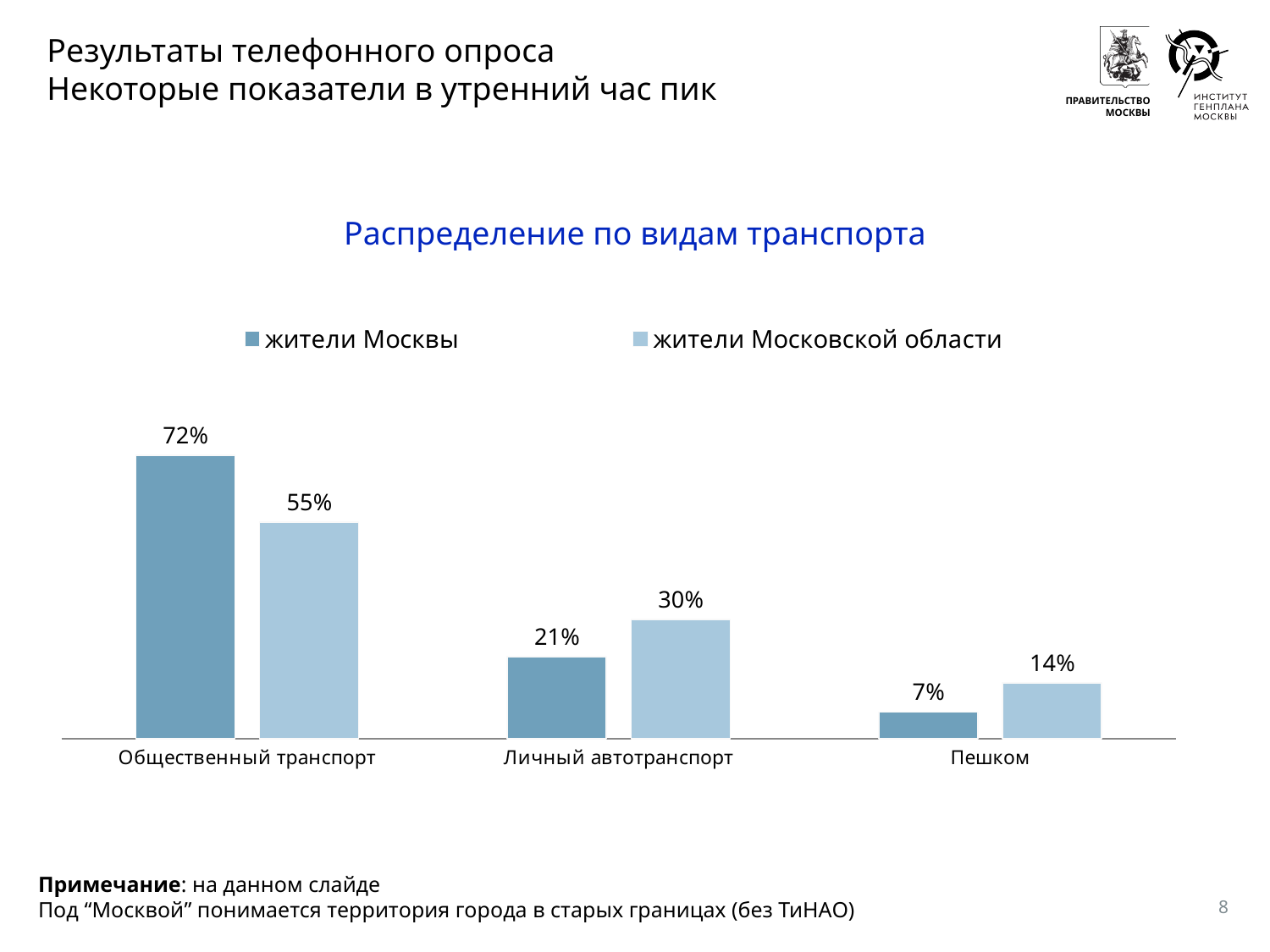
What is the difference between жители Московской области and жители Москвы in the Пешком category? 7% What is the difference between жители Москвы and жители Московской области in the Общественный транспорт category? 17% What is the value for жители Московской области in the Общественный транспорт category? 55% How many series does the legend list? 2 Which category has the highest value for жители Москвы? Общественный транспорт What is the value for жители Московской области in the Личный автотранспорт category? 30% How many categories are shown on the x axis? 3 What kind of chart is shown on the slide? bar chart Which category has the lowest value for жители Московской области? Пешком What is the value for жители Москвы in the Пешком category? 7% Which is larger in the Личный автотранспорт category: жители Москвы or жители Московской области? жители Московской области What is the value for жители Москвы in the Общественный транспорт category? 72%